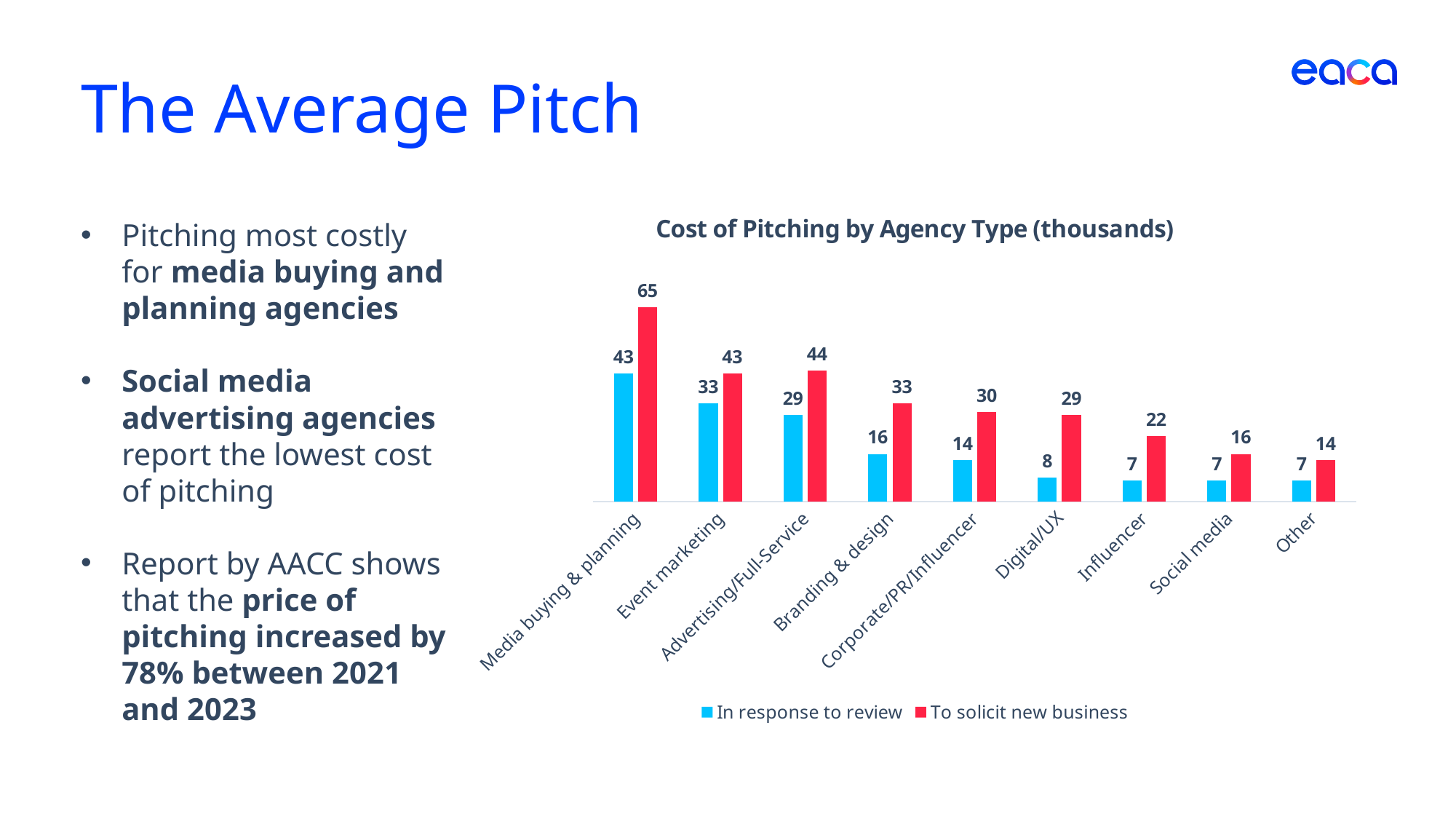
What is the title of the chart? Cost of Pitching by Agency Type (thousands) What kind of chart is shown on the slide? Bar chart What is the value for Influencer in the 'To solicit new business' series? 22 What is the difference between the 'To solicit new business' values for Event marketing and Branding & design? 10 What is the value for Advertising/Full-Service in the 'In response to review' series? 29 How many series does the legend list? 2 Which agency type has the highest value in the 'To solicit new business' series? Media buying & planning How many agency types are shown on the x axis? 9 Which is larger: the 'In response to review' value for Event marketing or for Corporate/PR/Influencer? Event marketing What is the value for Media buying & planning in the 'To solicit new business' series? 65 Which agency type has the lowest value in the 'To solicit new business' series? Other What is the difference between the 'To solicit new business' and 'In response to review' values for Media buying & planning? 22